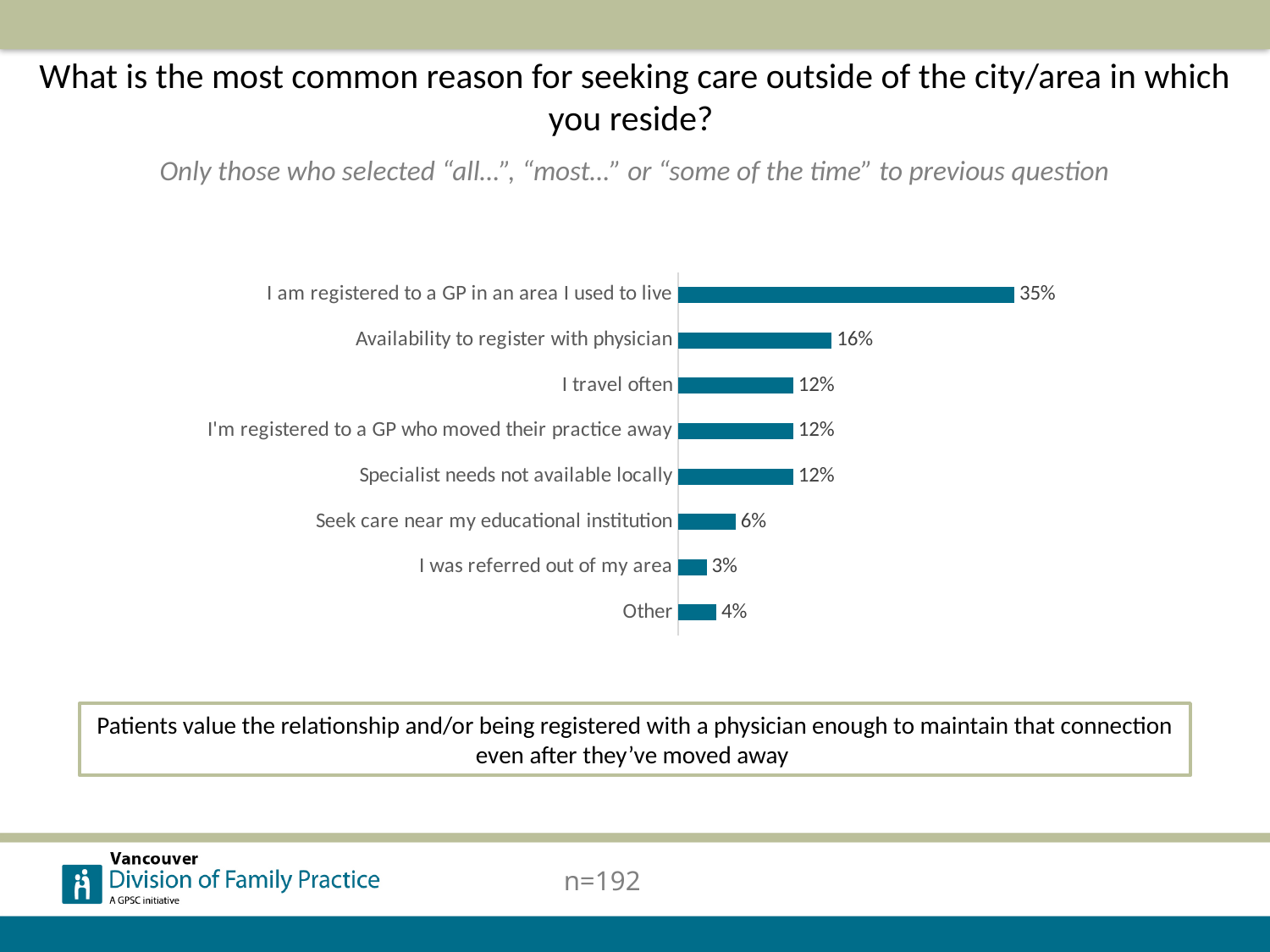
What is the difference between "I am registered to a GP in an area I used to live" and "Availability to register with physician"? 19% What sample size (n) is shown on the slide? n=192 What percentage is shown for "Seek care near my educational institution"? 6% Which is larger: "Other" or "I was referred out of my area"? Other What type of chart is shown on the slide? Bar chart Which reason has the highest percentage? I am registered to a GP in an area I used to live What percentage of respondents selected "I am registered to a GP in an area I used to live"? 35% How many reasons (categories) are shown in the chart? 8 Which reason has the lowest percentage? I was referred out of my area What is the difference between "I travel often" and "I was referred out of my area"? 9% What is the value for "Availability to register with physician"? 16% What is the value for "Other"? 4%